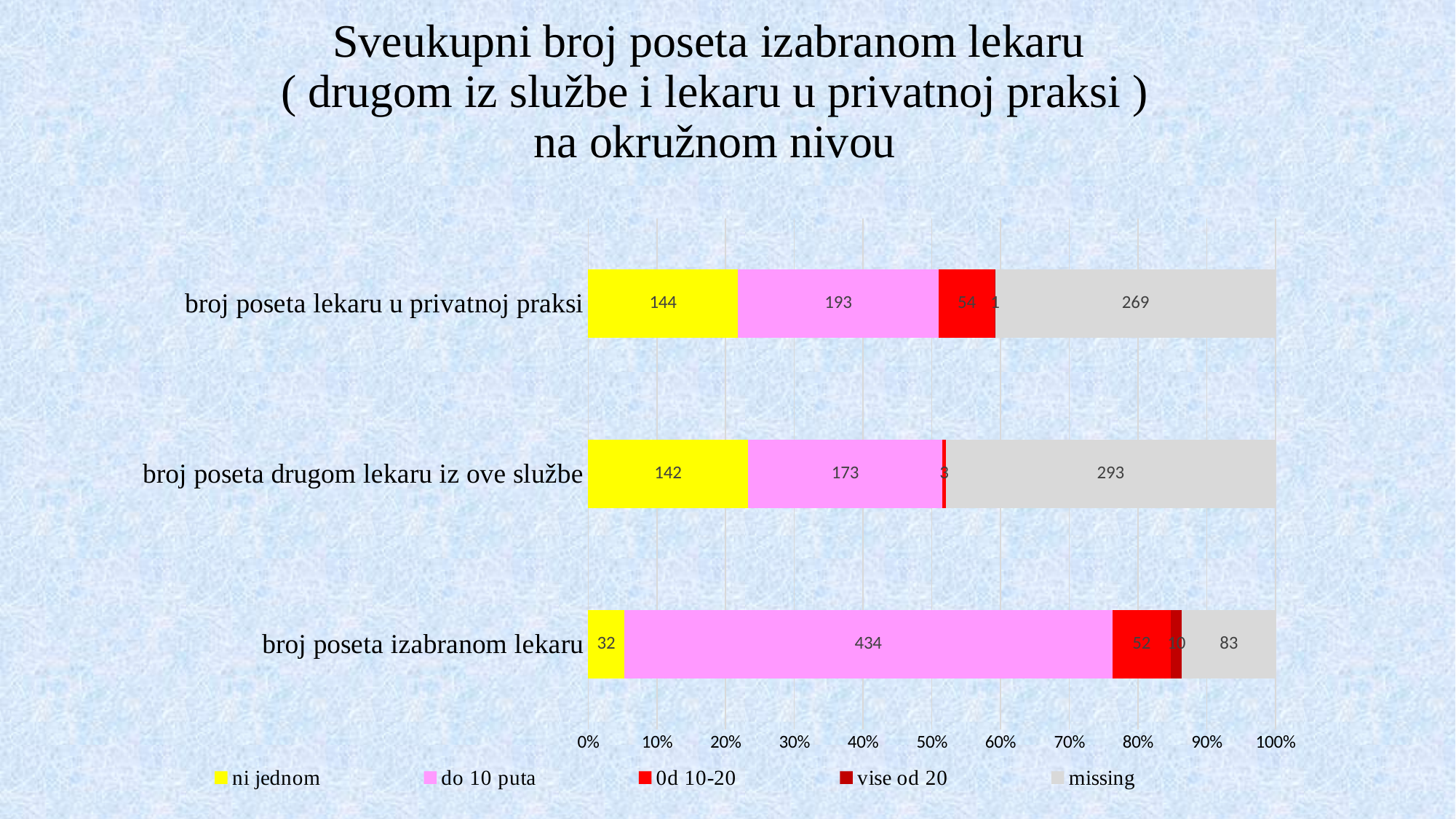
What kind of chart is shown on the slide? bar chart How many categories are plotted on the chart? 3 What is the 'missing' value for 'broj poseta drugom lekaru iz ove službe'? 293 How many series does the legend list? 5 What is the 'ni jednom' value for 'broj poseta lekaru u privatnoj praksi'? 144 Which category has the lowest 'missing' value? broj poseta izabranom lekaru Which is larger: the 'ni jednom' value for 'broj poseta lekaru u privatnoj praksi' or for 'broj poseta izabranom lekaru'? broj poseta lekaru u privatnoj praksi What is the '0d 10-20' value for 'broj poseta lekaru u privatnoj praksi'? 54 What colour represents the 'missing' series in the legend? grey Which category has the highest 'do 10 puta' value? broj poseta izabranom lekaru What is the 'do 10 puta' value for 'broj poseta izabranom lekaru'? 434 What is the difference between the 'missing' values for 'broj poseta drugom lekaru iz ove službe' and 'broj poseta lekaru u privatnoj praksi'? 24